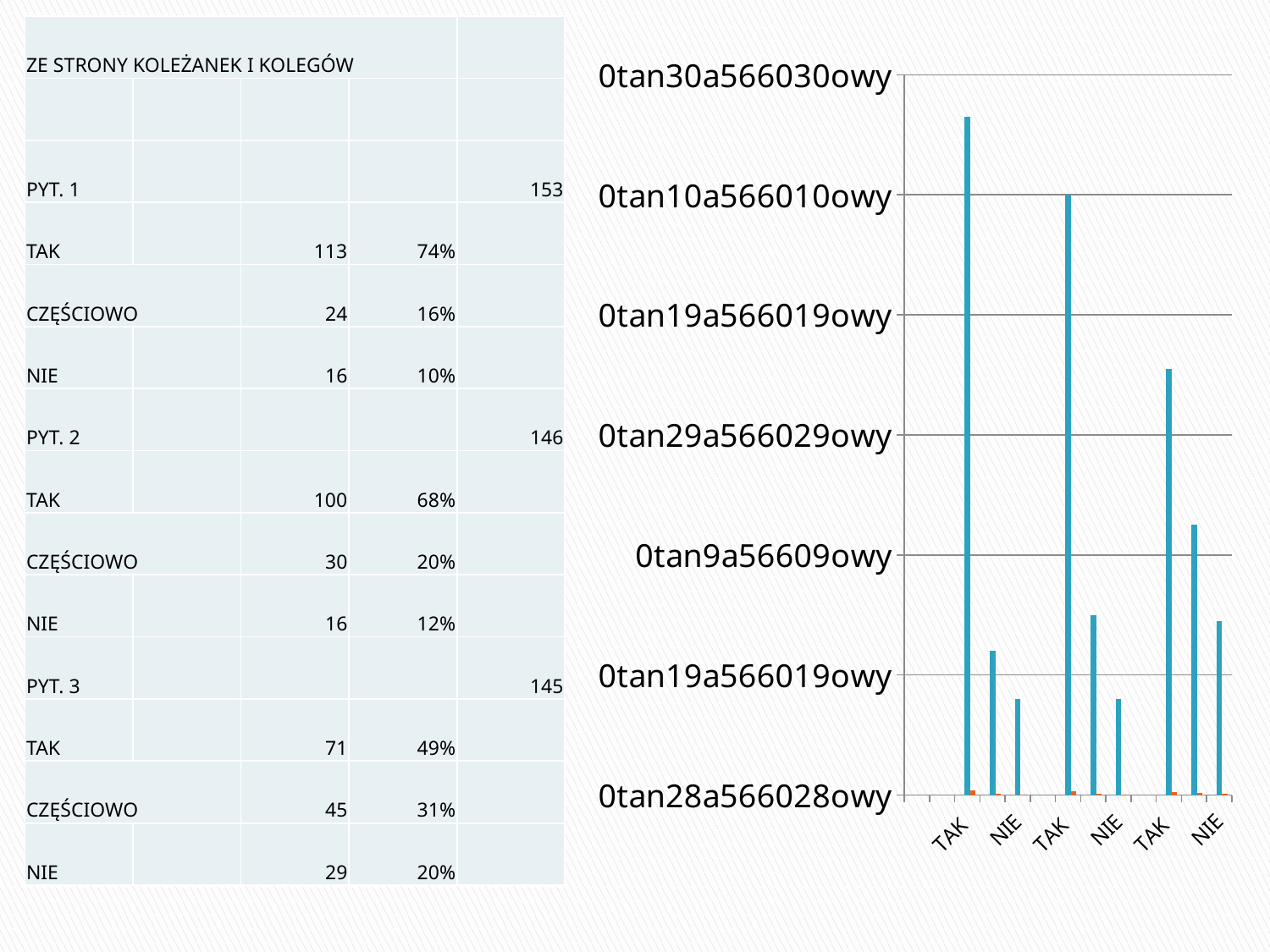
What colour are the tall bars in the chart? blue Which bar in the chart is the tallest? the leftmost TAK bar How many x-axis labels in the chart read "TAK"? 3 In the chart, which is taller: the first NIE bar or the third (rightmost) NIE bar? the third NIE bar What kind of chart is shown on the right side of the slide? bar chart In the chart, which is taller: the second TAK bar or the third TAK bar? the second TAK bar How many x-axis labels in the chart read "NIE"? 3 Within each group of three bars in the chart, is the TAK bar the tallest or the shortest of its group? tallest How many tall blue bars are plotted in the chart? 9